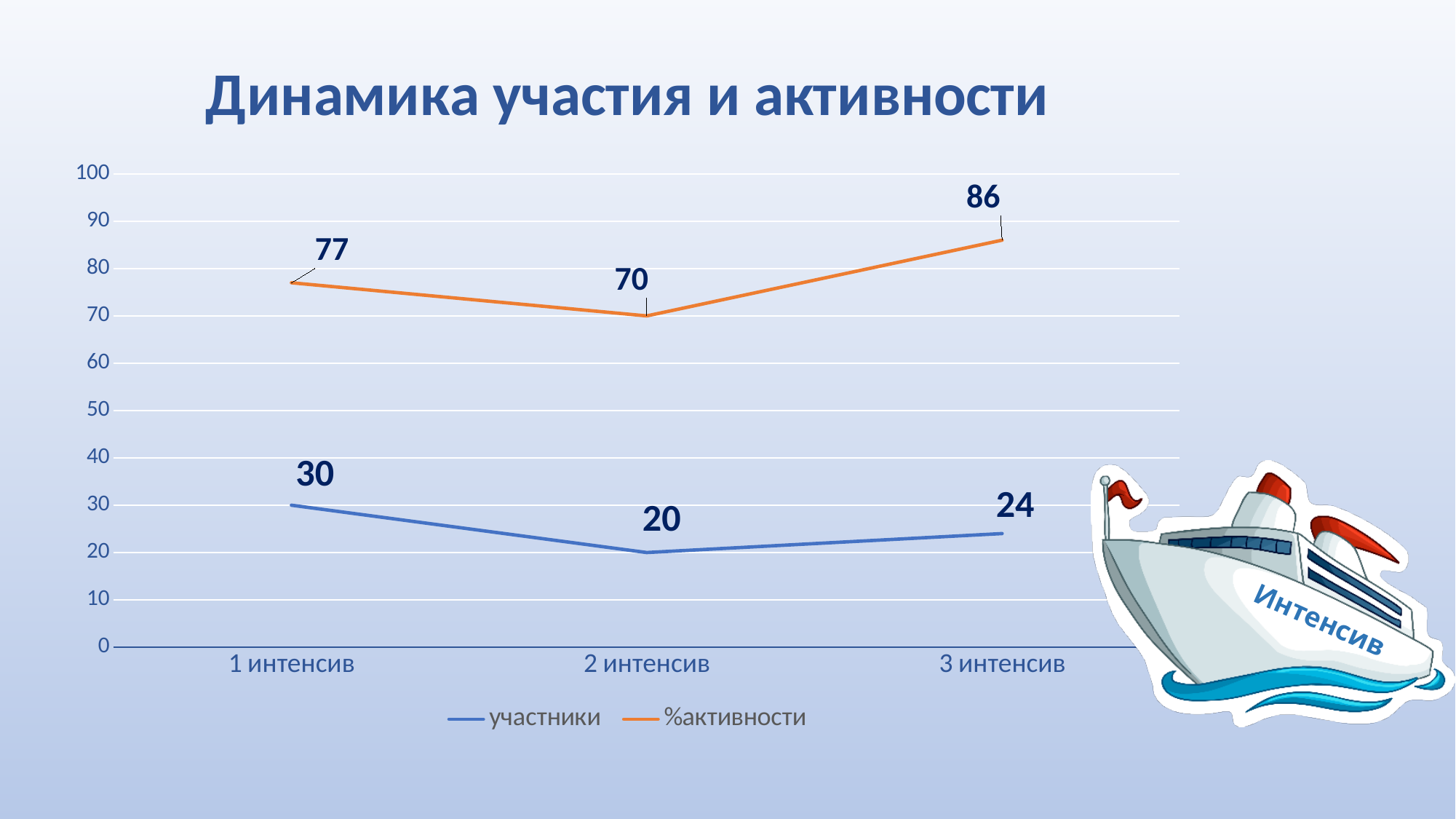
What is the value for участники at 3 интенсив? 24 Which is larger: участники at 1 интенсив or участники at 3 интенсив? 1 интенсив How many categories are shown on the x axis? 3 What is the value for %активности at 3 интенсив? 86 How many series does the legend list? 2 What kind of chart is shown on the slide? line chart At which category is %активности highest? 3 интенсив What is the value for участники at 1 интенсив? 30 What is the title of the chart? Динамика участия и активности What is the value for %активности at 2 интенсив? 70 At which category is участники lowest? 2 интенсив What is the difference between %активности at 3 интенсив and at 2 интенсив? 16